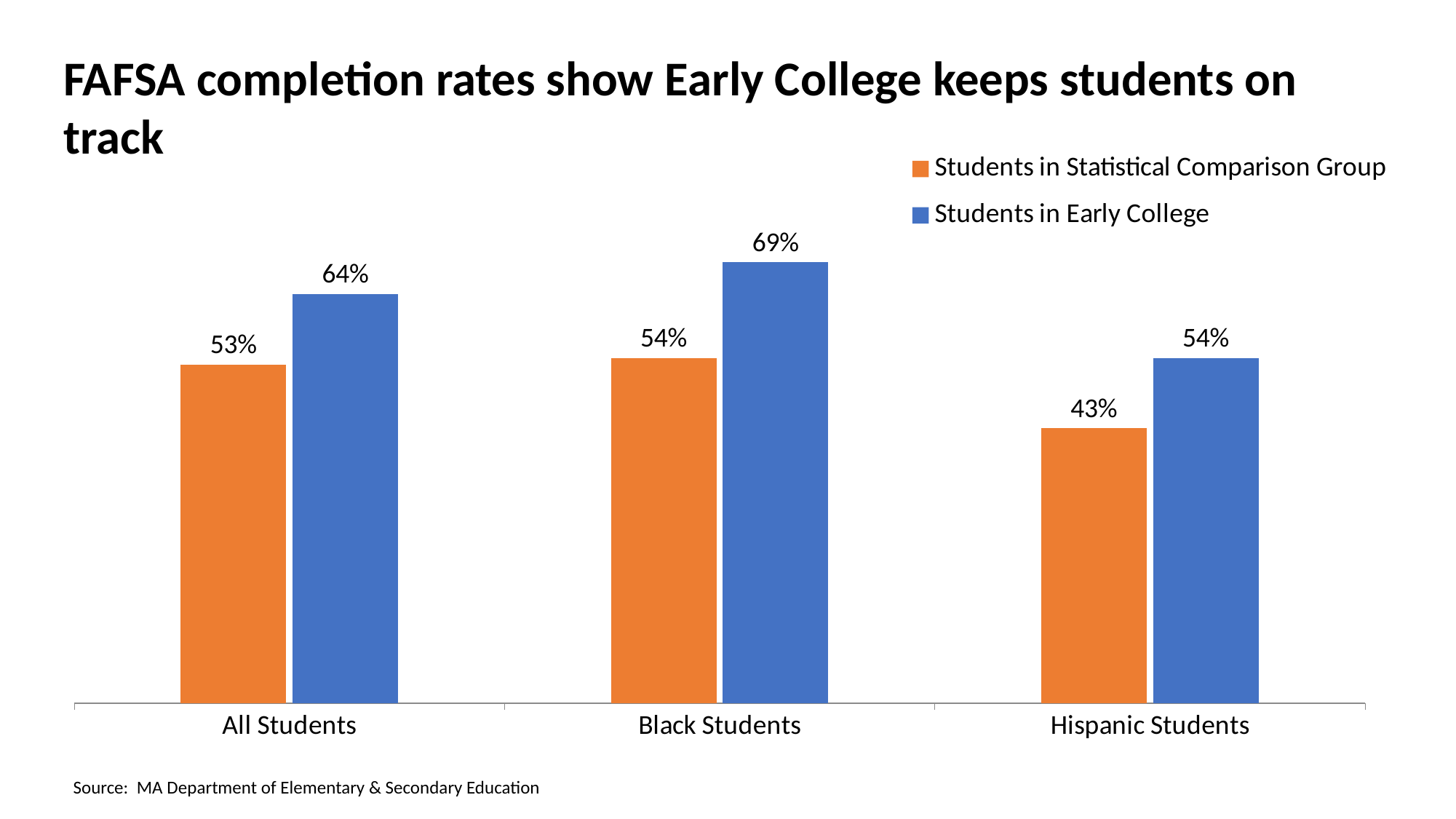
What is the FAFSA completion rate for Students in Early College among All Students? 64% What is the FAFSA completion rate for Students in Statistical Comparison Group among Hispanic Students? 43% For All Students, which series has the larger FAFSA completion rate? Students in Early College What is the FAFSA completion rate for Students in Early College among Black Students? 69% How many series does the legend list? 2 What kind of chart is shown on the slide? Bar chart How many student groups are shown on the x axis? 3 Which student group has the highest FAFSA completion rate for Students in Early College? Black Students What is the difference between the Early College and Statistical Comparison Group rates for Hispanic Students? 11 percentage points What is the difference between the Early College and Statistical Comparison Group rates for Black Students? 15 percentage points Which colour represents Students in Early College in the chart? Blue Which student group has the lowest FAFSA completion rate for Students in Statistical Comparison Group? Hispanic Students